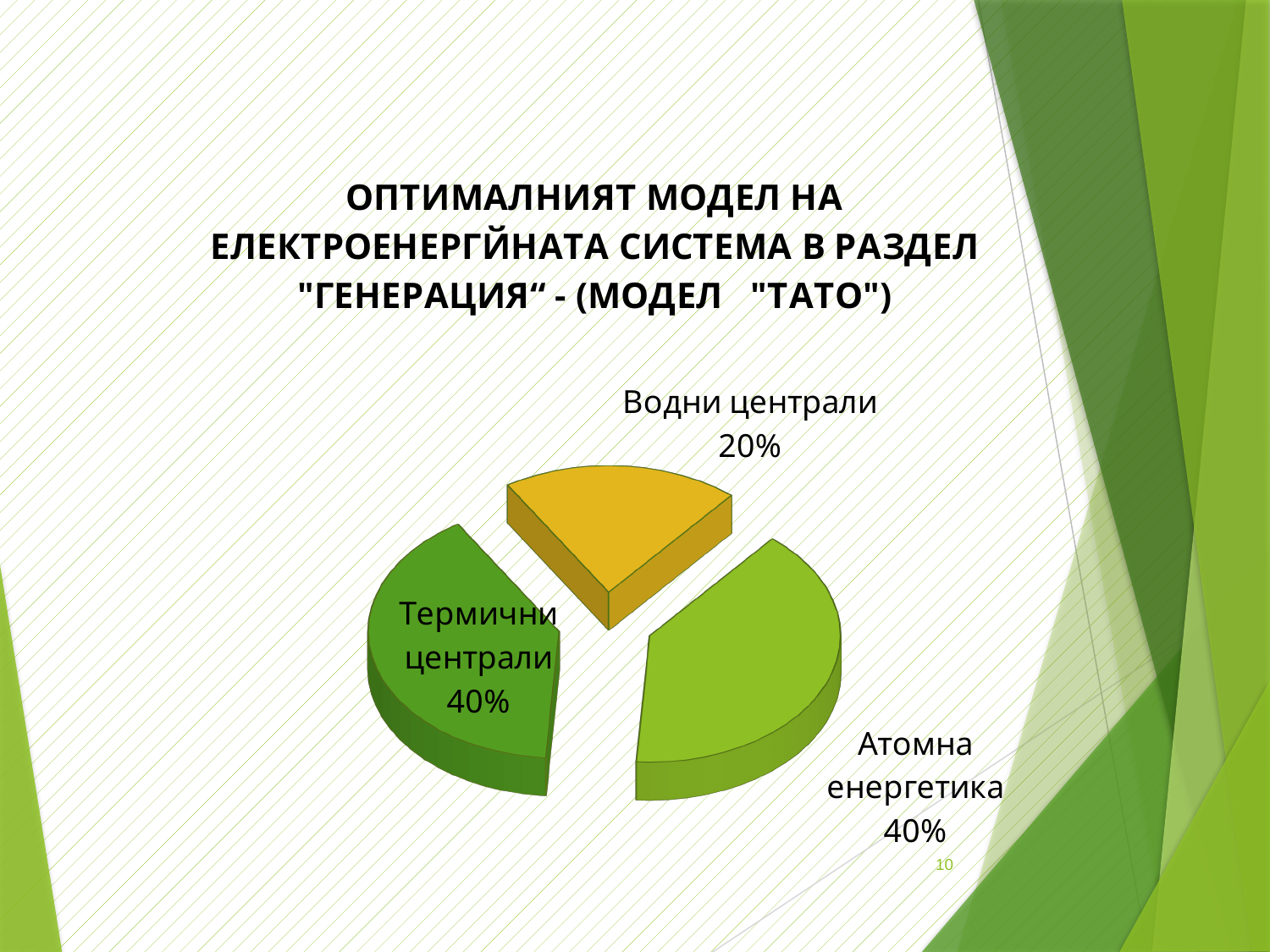
What share of the pie does Водни централи have? 20% Is the share of Водни централи greater or less than 25%? less Which category has the smallest share of the pie? Водни централи Which is larger, the share of Атомна енергетика or the share of Водни централи? Атомна енергетика What is the combined share of Термични централи and Атомна енергетика? 80% What share of the pie does Термични централи have? 40% What kind of chart is shown on the slide? Pie chart What share of the pie does Атомна енергетика have? 40% What is the difference between the share of Термични централи and the share of Водни централи? 20% Which slice of the pie is coloured yellow? Водни централи How many slices does the pie chart have? 3